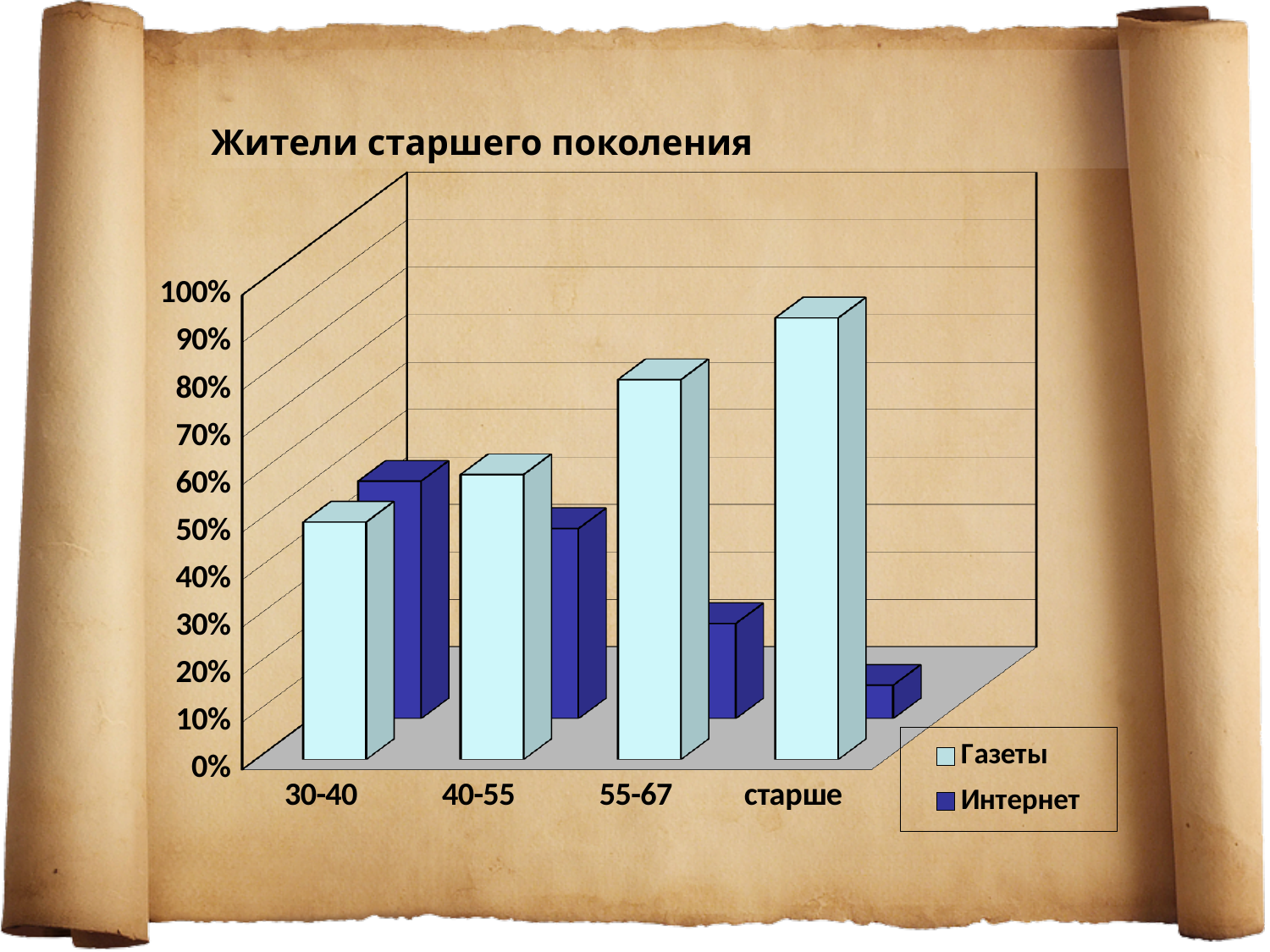
For the 55-67 category, which is larger: Газеты or Интернет? Газеты What is the title of the chart? Жители старшего поколения Do the Интернет values rise or fall from 30-40 to старше? fall Which age category has the lowest value for Интернет? старше Which age category has the lowest value for Газеты? 30-40 Is the Интернет value for старше greater or less than 30%? less Do the Газеты values rise or fall from 30-40 to старше? rise Is the Газеты value for старше greater or less than 80%? greater Which age category has the highest value for Газеты? старше How many series does the legend list? 2 How many age categories are shown on the x axis? 4 What kind of chart is shown on the slide? bar chart